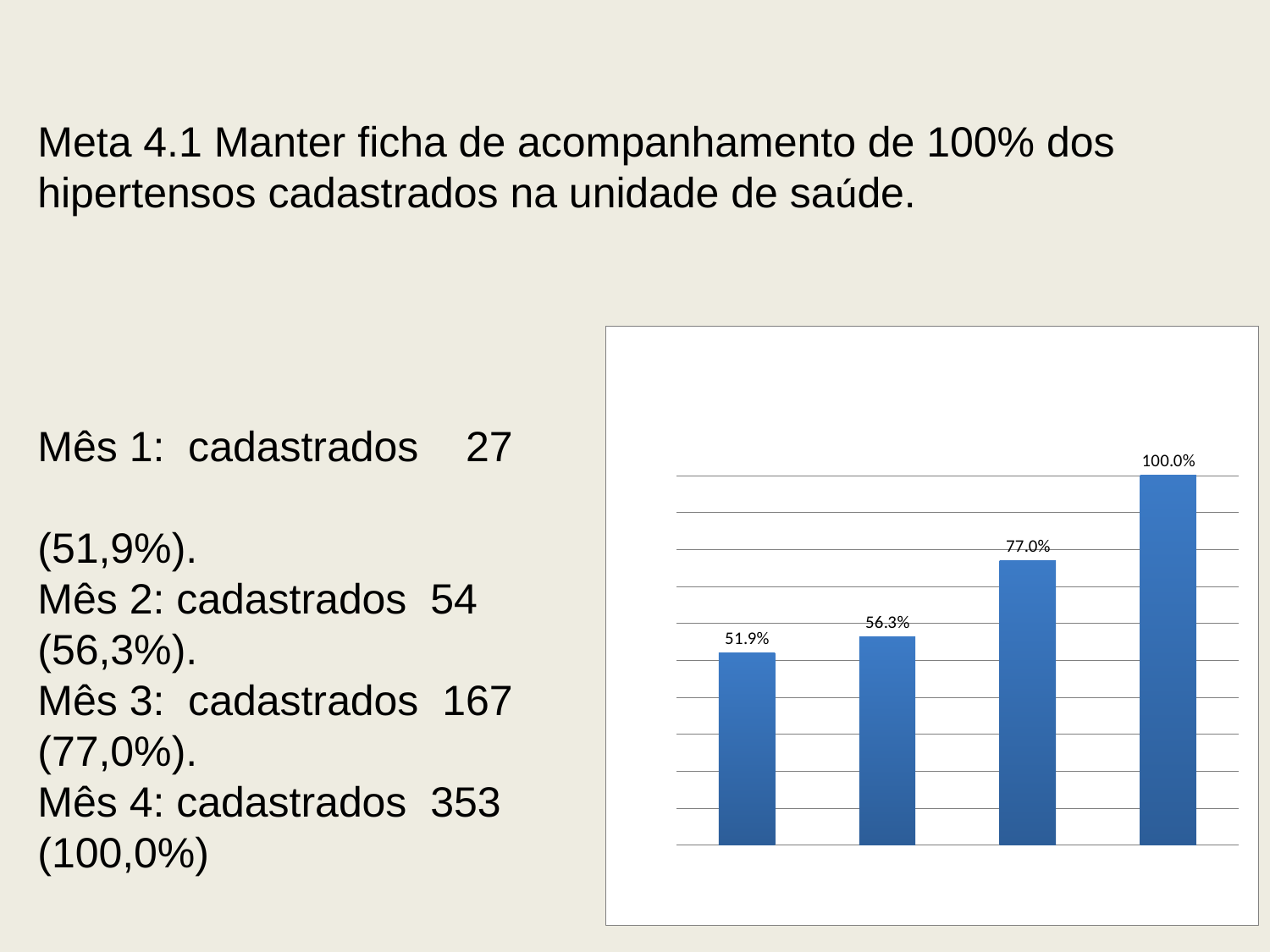
What is the value shown on the first (leftmost) bar of the chart? 51.9% What is the value shown on the third bar of the chart? 77.0% What type of chart is shown on the slide? bar chart Which bar in the chart has the lowest value? the first (leftmost) bar What is the value shown on the fourth (rightmost) bar of the chart? 100.0% What is the difference between the values of the fourth bar and the third bar? 23.0% How many bars are plotted in the chart? 4 What is the value shown on the second bar of the chart? 56.3% What is the difference between the values of the second bar and the first bar? 4.4% Which is larger, the value of the third bar or the value of the second bar? the third bar Which bar in the chart has the highest value? the fourth (rightmost) bar Do the bar values rise or fall from left to right across the chart? rise